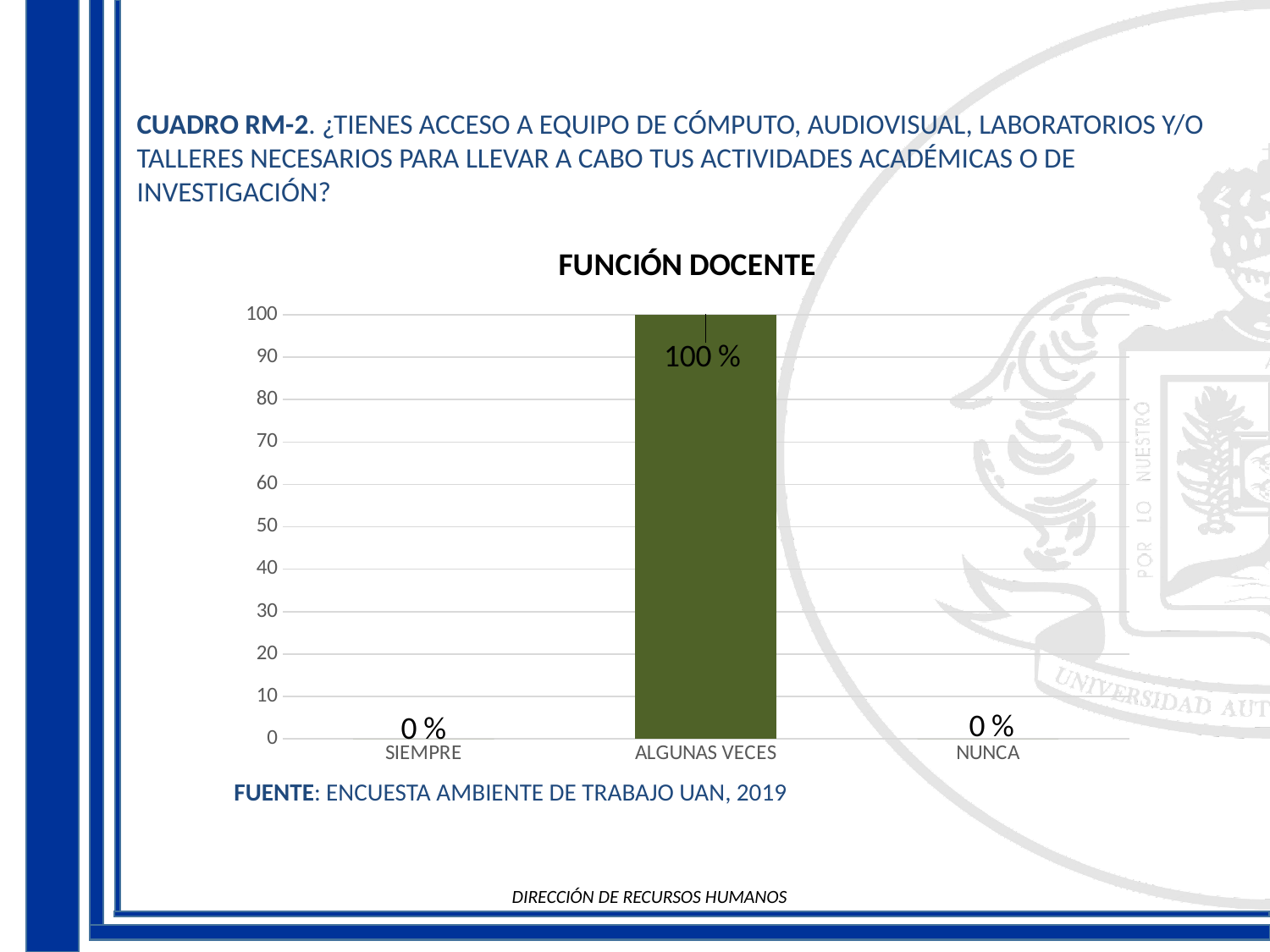
What is the title of the chart? FUNCIÓN DOCENTE What is the value for SIEMPRE? 0 % What is the value for NUNCA? 0 % What is the highest value shown on the y axis? 100 What is the difference between the values for ALGUNAS VECES and SIEMPRE? 100 % What kind of chart is shown? bar chart How many categories are shown on the x axis? 3 Is the value for ALGUNAS VECES greater or less than 50? greater Which category has the highest value? ALGUNAS VECES Which is larger, the value for ALGUNAS VECES or the value for NUNCA? ALGUNAS VECES What is the value for ALGUNAS VECES? 100 %